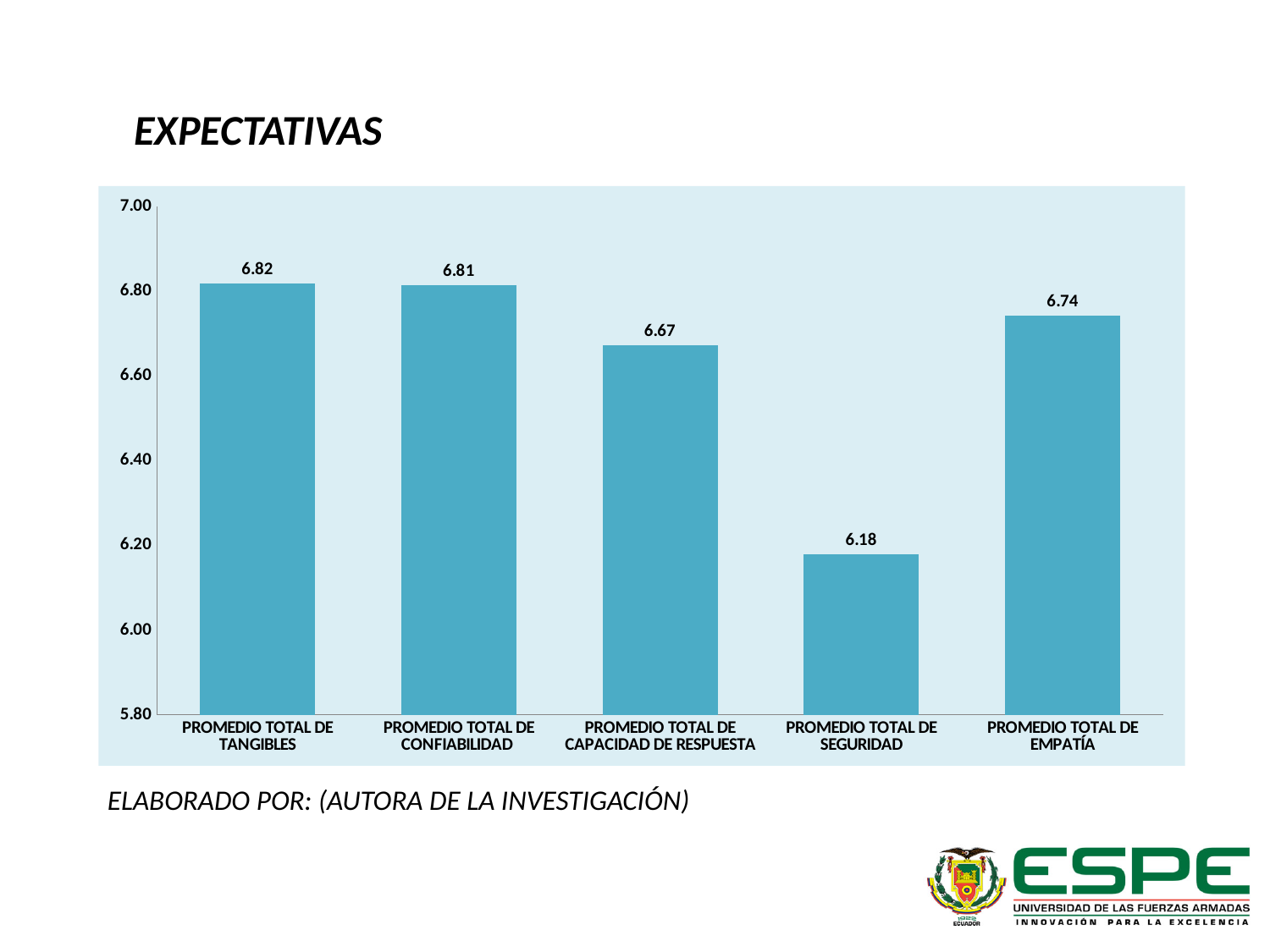
Which is larger, the value for PROMEDIO TOTAL DE CAPACIDAD DE RESPUESTA or PROMEDIO TOTAL DE EMPATÍA? PROMEDIO TOTAL DE EMPATÍA What is the difference between the values for PROMEDIO TOTAL DE TANGIBLES and PROMEDIO TOTAL DE SEGURIDAD? 0.64 Is the value for PROMEDIO TOTAL DE SEGURIDAD greater or less than 6.40? less How many categories are shown in the chart? 5 What is the value for PROMEDIO TOTAL DE SEGURIDAD? 6.18 Which category has the lowest value? PROMEDIO TOTAL DE SEGURIDAD What is the value for PROMEDIO TOTAL DE TANGIBLES? 6.82 What is the value for PROMEDIO TOTAL DE EMPATÍA? 6.74 What is the title shown above the chart? EXPECTATIVAS What is the value for PROMEDIO TOTAL DE CAPACIDAD DE RESPUESTA? 6.67 What is the difference between the values for PROMEDIO TOTAL DE CONFIABILIDAD and PROMEDIO TOTAL DE EMPATÍA? 0.07 What kind of chart is shown on the slide? bar chart